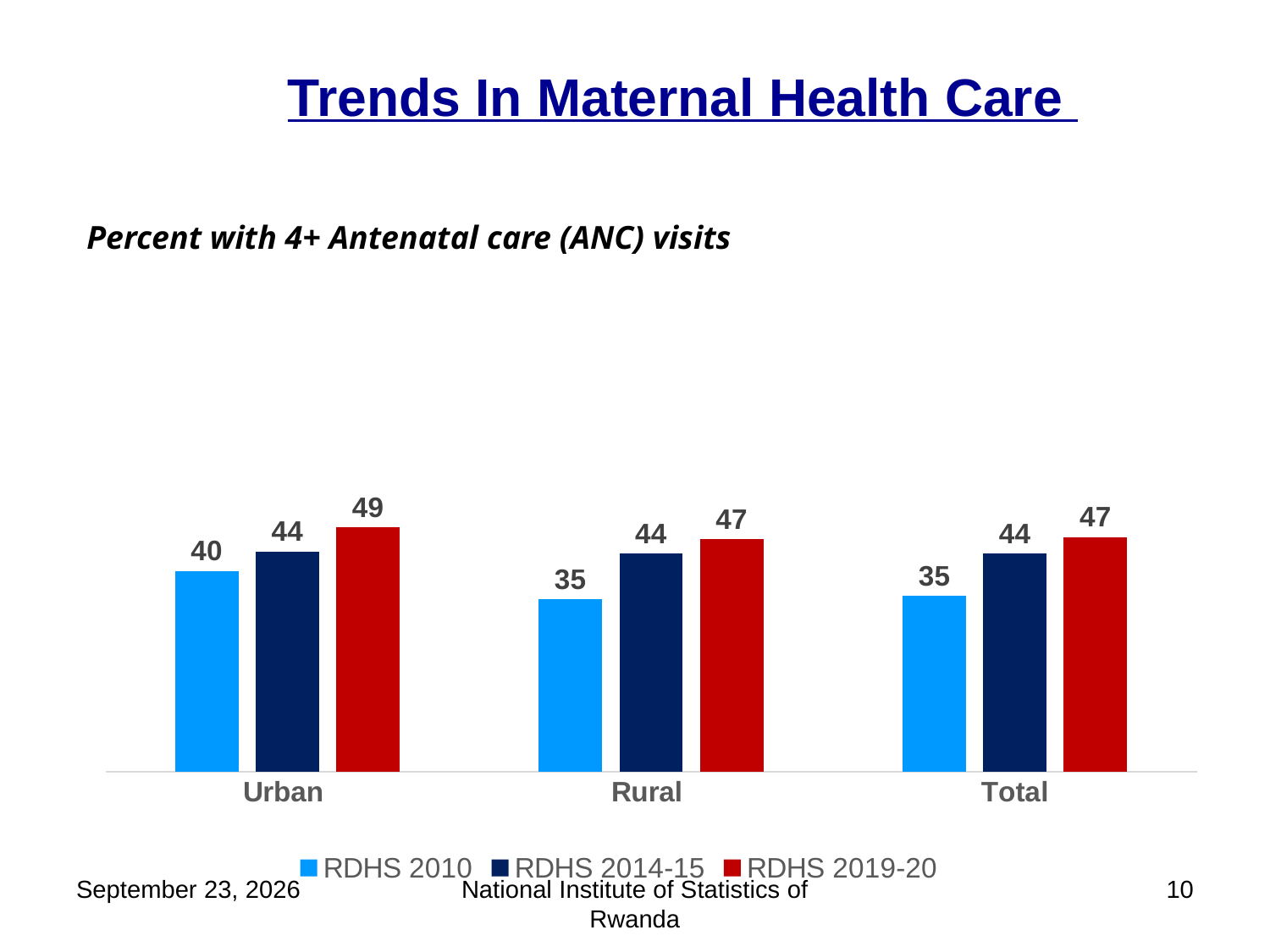
Which category has the lowest value in the RDHS 2010 series? Rural and Total (both 35) Which is larger: the RDHS 2010 value for Urban or the RDHS 2010 value for Rural? Urban How many series does the legend list? 3 What is the difference between the RDHS 2019-20 and RDHS 2010 values for Rural? 12 What is the value for Urban in the RDHS 2010 series? 40 What is the value for Rural in the RDHS 2019-20 series? 47 How many categories are shown on the x axis? 3 What is the value for Total in the RDHS 2014-15 series? 44 Which category has the highest value in the RDHS 2019-20 series? Urban What kind of chart is shown on the slide? Bar chart What is the difference between the RDHS 2019-20 and RDHS 2010 values for Urban? 9 Do the values for Total rise or fall from RDHS 2010 to RDHS 2019-20? Rise